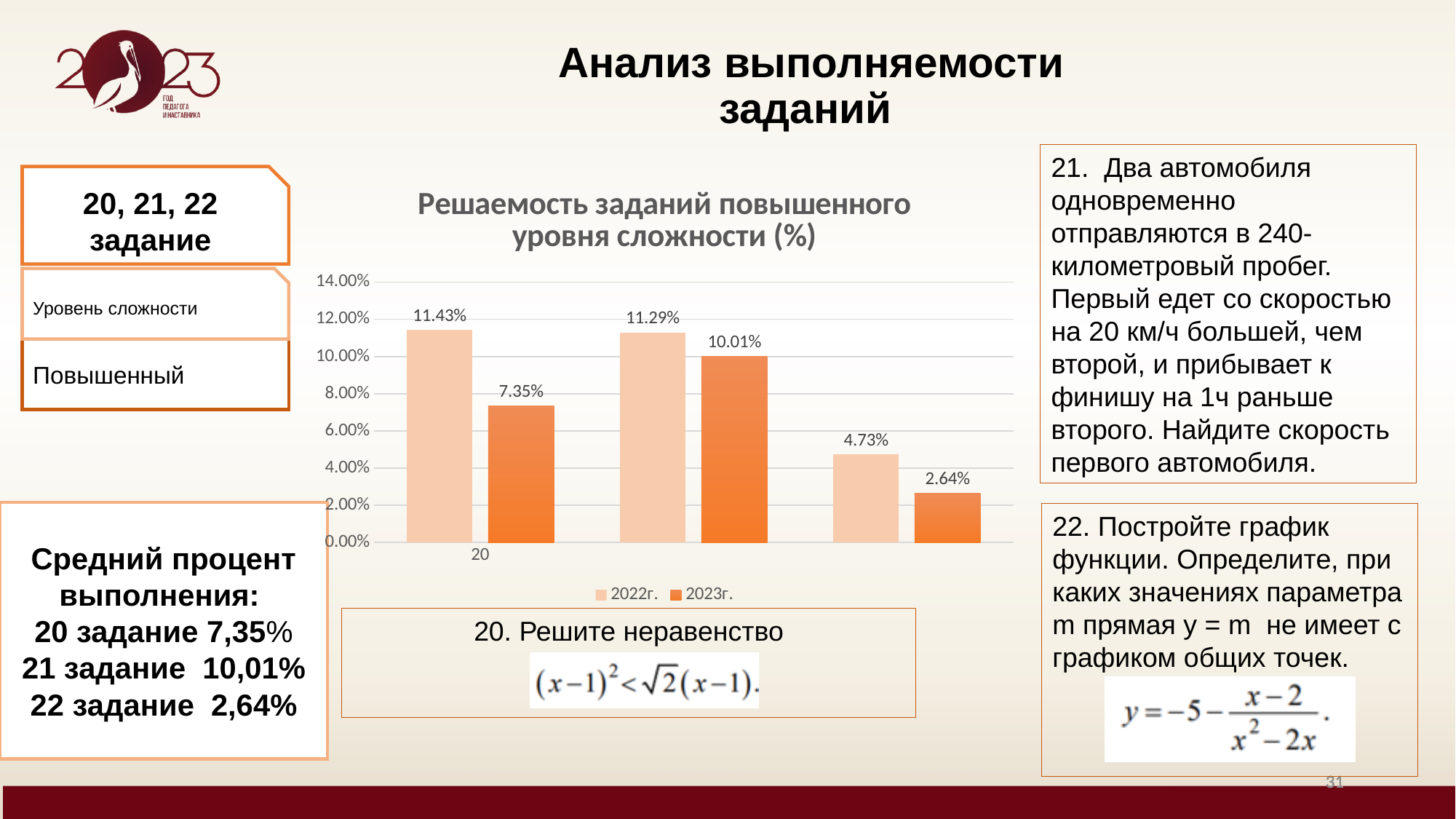
What is the value of the 2023г. bar for category 20? 7.35% For category 20, which series has the larger value, 2022г. or 2023г.? 2022г. What is the lowest value shown on the chart? 2.64% What is the difference between the 2022г. and 2023г. values for category 20? 4.08% What is the difference between the 2022г. and 2023г. values in the middle group of bars? 1.28% How many groups of bars are plotted on the chart? 3 What is the highest value shown on the chart? 11.43% What is the value of the 2022г. bar for category 20? 11.43% What is the value of the 2023г. bar in the middle group of bars? 10.01% Do the 2022г. values rise or fall from left to right across the groups? fall How many series does the legend list? 2 What kind of chart is shown on the slide? bar chart